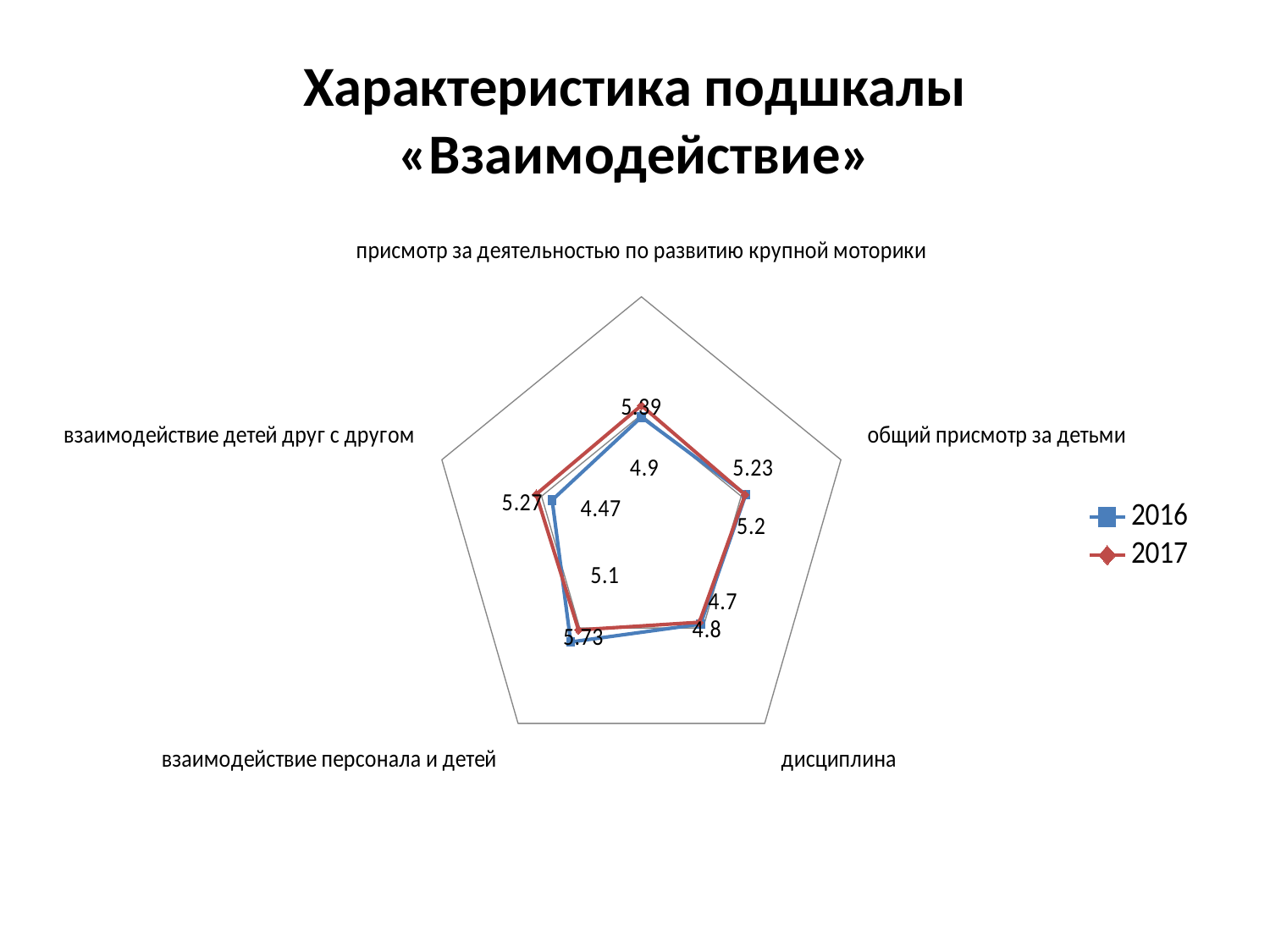
What is the lowest value printed anywhere on the chart? 4.47 What kind of chart is shown on the slide? Radar chart Which two values are printed on the axis «общий присмотр за детьми»? 5.23 and 5.2 What is the highest value printed anywhere on the chart? 5.73 How many categories (axes) does the radar chart have? 5 Which two values are printed on the axis «присмотр за деятельностью по развитию крупной моторики»? 5.39 and 4.9 What is the title of the slide? Характеристика подшкалы «Взаимодействие» Which two values are printed on the axis «взаимодействие детей друг с другом»? 5.27 and 4.47 Which series are listed in the legend? 2016 and 2017 Which two values are printed on the axis «дисциплина»? 4.7 and 4.8 Which two values are printed on the axis «взаимодействие персонала и детей»? 5.73 and 5.1 How many series does the legend list? 2